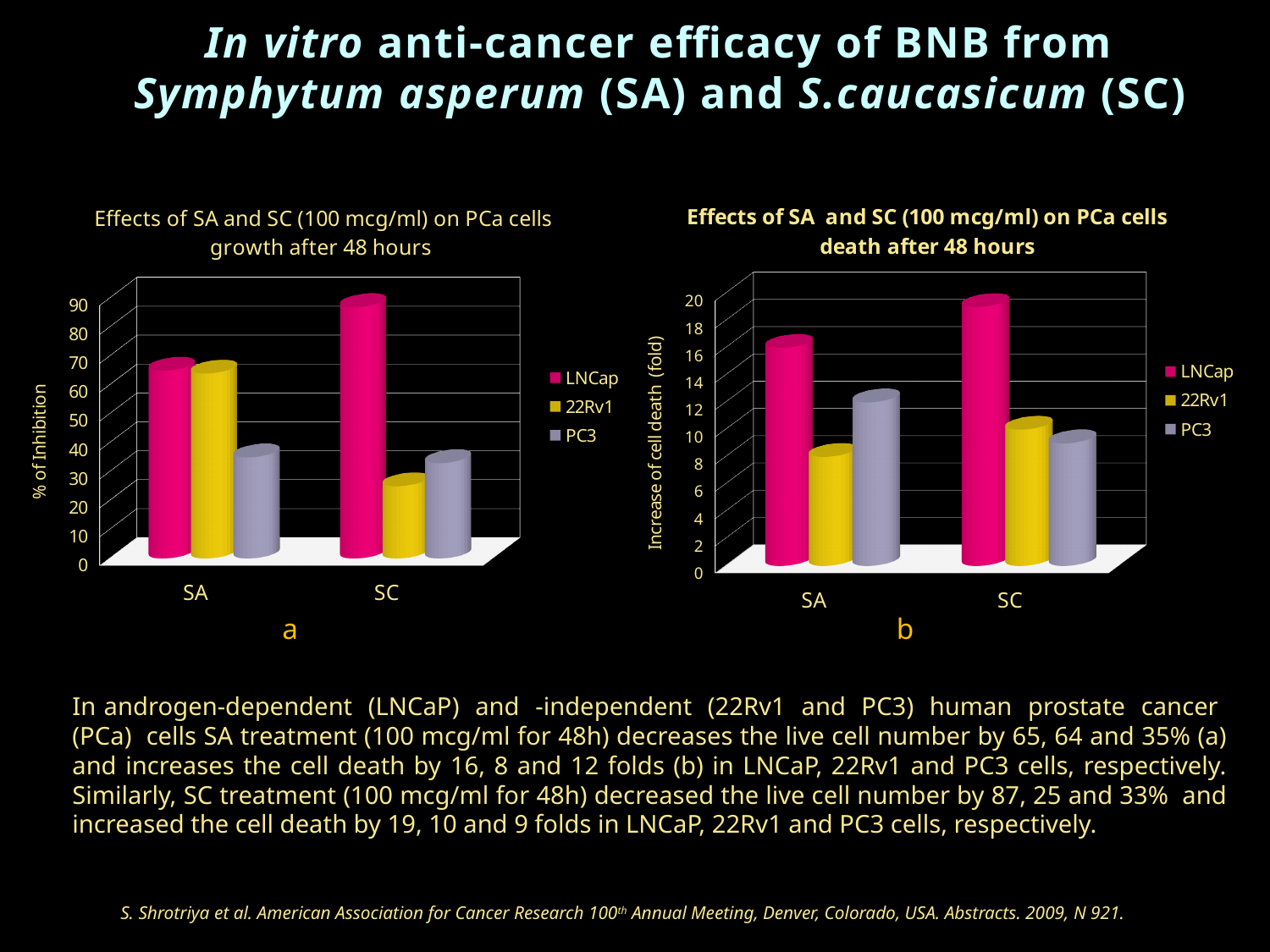
What kind of chart is chart a, 'Effects of SA and SC (100 mcg/ml) on PCa cells growth after 48 hours'? Bar chart In chart b (PCa cells death), is the value for LNCap under SA greater or less than 14? greater In chart b (PCa cells death), how many categories are shown on the x axis? 2 In chart b (PCa cells death), is the value for 22Rv1 under SC greater or less than 12? less In chart a (PCa cells growth), how many series does the legend list? 3 In chart a (PCa cells growth), which bar is the highest? LNCap for SC In chart b (PCa cells death), under SA, is the value larger for LNCap or for PC3? LNCap What is the y-axis label of chart b (PCa cells death)? Increase of cell death (fold) In chart b (PCa cells death), which bar is the highest? LNCap for SC In chart a (PCa cells growth), is the 22Rv1 value larger for SA or for SC? SA In chart a (PCa cells growth), is the value for LNCap under SC greater or less than 80? greater